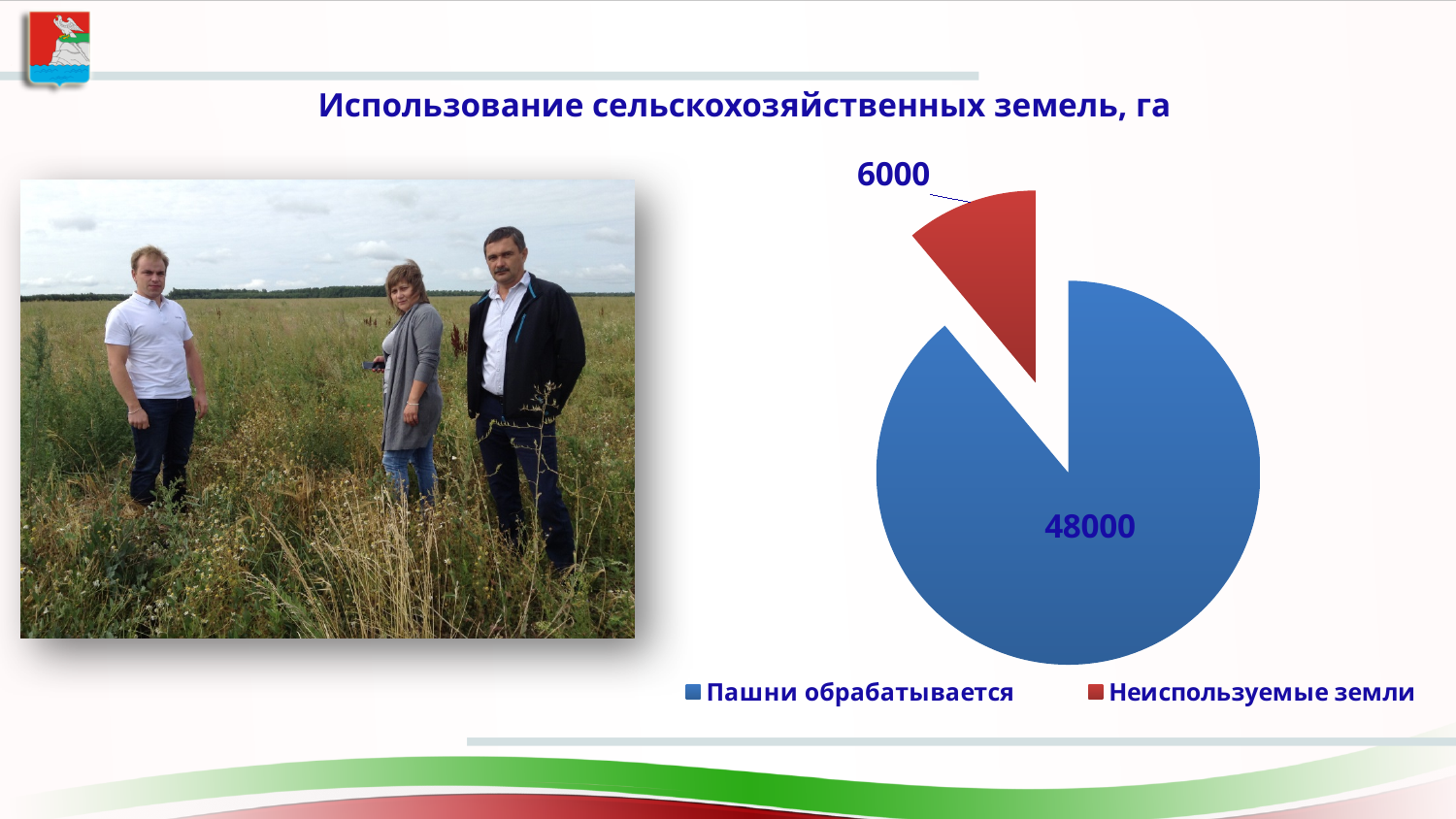
How many entries does the legend list? 2 What is the title of the chart? Использование сельскохозяйственных земель, га What is the value for "Пашни обрабатывается"? 48000 What is the total of all slices in the pie chart? 54000 How many slices does the pie chart have? 2 Which category has the smallest slice of the pie? Неиспользуемые земли Which is larger, the value for "Пашни обрабатывается" or for "Неиспользуемые земли"? Пашни обрабатывается What is the difference between the values for "Пашни обрабатывается" and "Неиспользуемые земли"? 42000 Which category has the largest slice of the pie? Пашни обрабатывается What is the value for "Неиспользуемые земли"? 6000 What type of chart is shown on the slide? pie chart What colour is the slice for "Неиспользуемые земли"? red